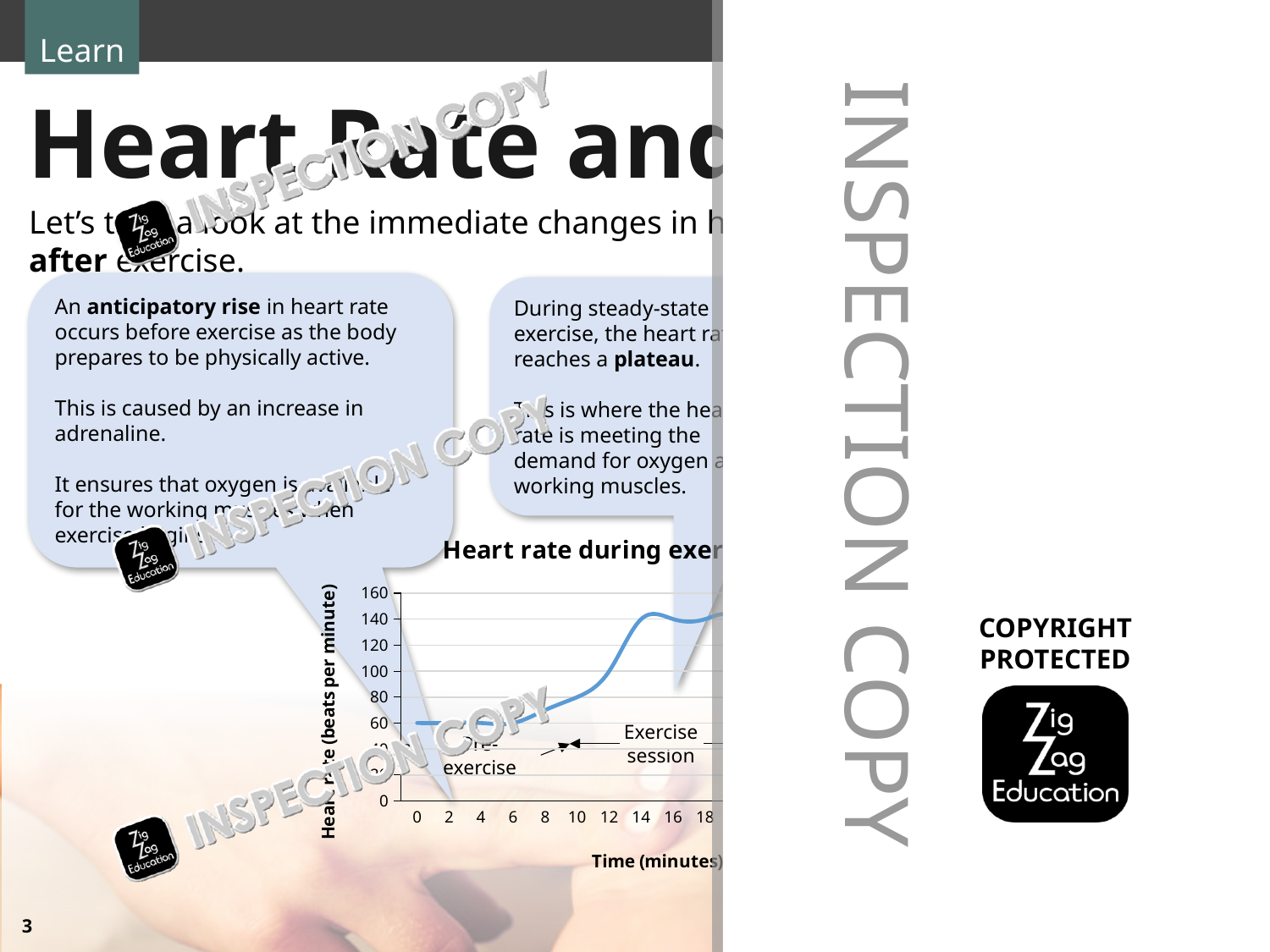
What kind of chart is shown on the slide? line chart Is the heart rate at 16 minutes greater or less than 100 beats per minute? greater Is the heart rate at 2 minutes greater or less than 100 beats per minute? less Is the heart rate at 0 minutes greater or less than 80 beats per minute? less Which is lower, the heart rate at 0 minutes or the heart rate at 10 minutes? 0 minutes Does the heart rate rise or fall as time increases from 0 to 14 minutes? rise What is the label of the x axis of the chart? Time (minutes) Which is higher, the heart rate at 2 minutes or the heart rate at 14 minutes? 14 minutes What is the label of the y axis of the chart? Heart rate (beats per minute)